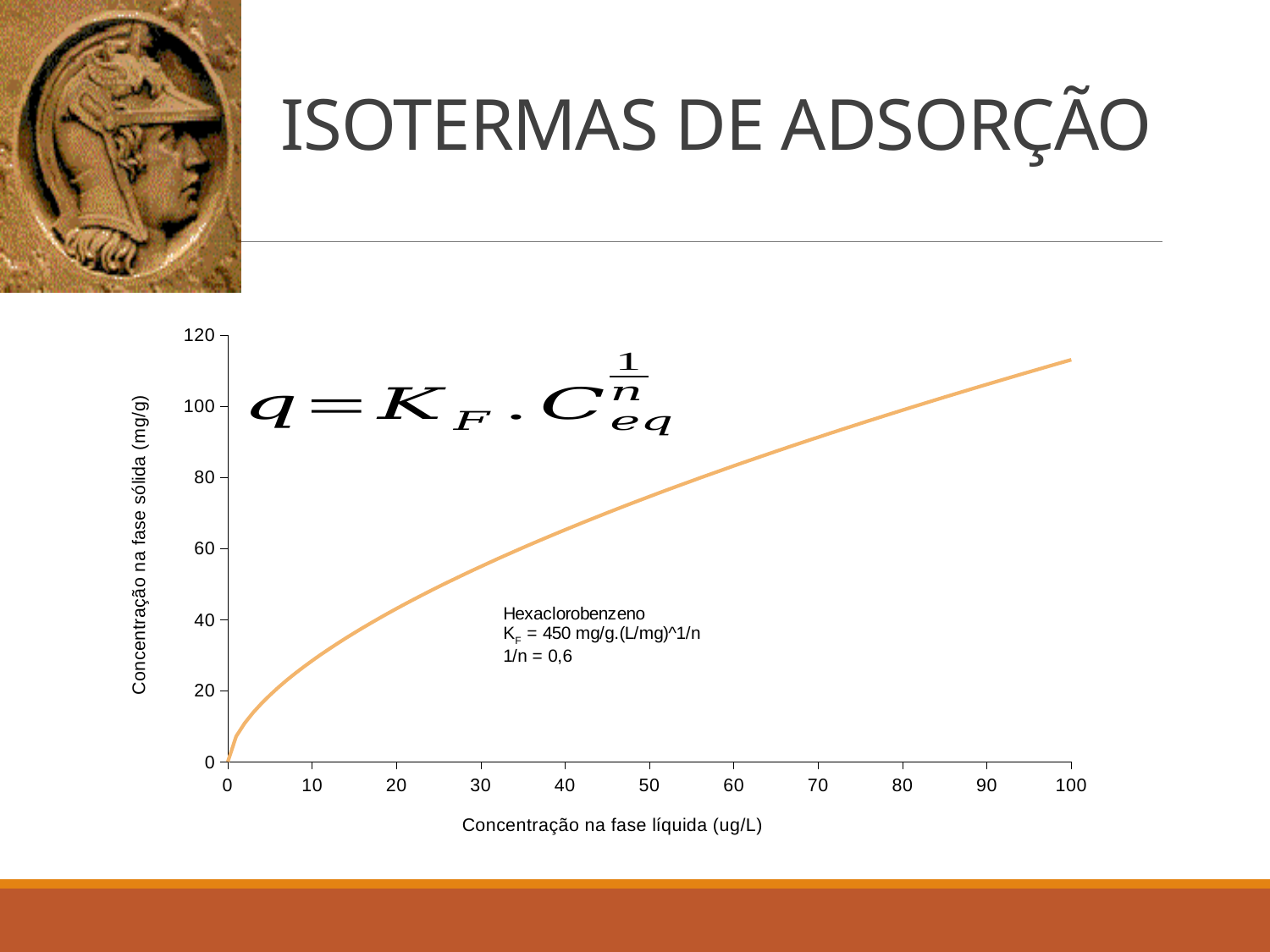
What is the label of the x axis of the chart? Concentração na fase líquida (ug/L) Is the value of the curve at a liquid-phase concentration of 20 ug/L greater or less than 60 mg/g? less Is the value of the curve at a liquid-phase concentration of 80 ug/L greater or less than 80 mg/g? greater Is the value of the curve at a liquid-phase concentration of 10 ug/L greater or less than 20 mg/g? greater What is the maximum value shown on the y axis of the chart? 120 What is the label of the y axis of the chart? Concentração na fase sólida (mg/g) What kind of chart is shown on the slide? line chart Do the values on the curve rise or fall as the concentration in the liquid phase increases? rise